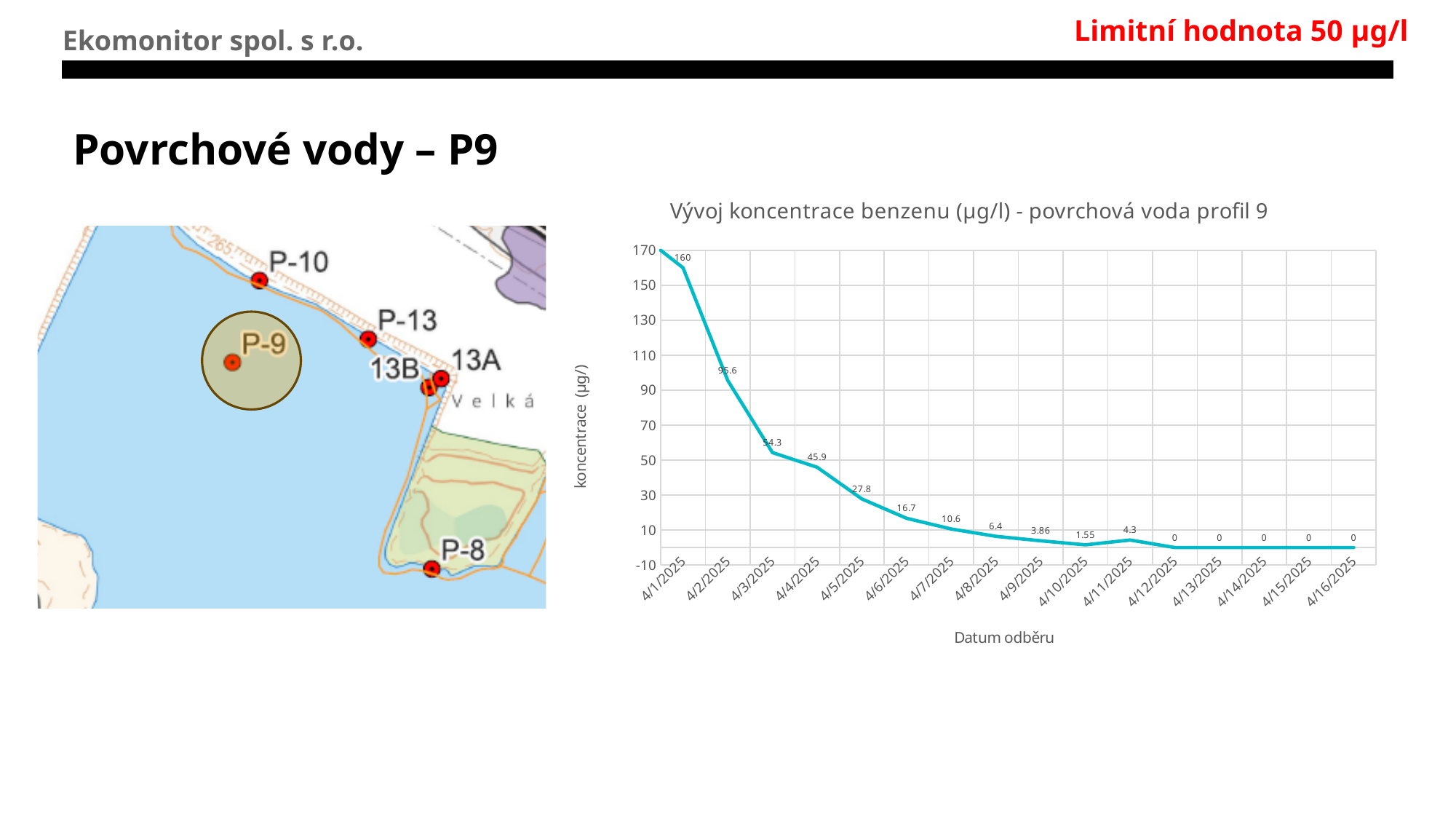
What type of chart is shown on the slide? line chart What is the title of the chart? Vývoj koncentrace benzenu (µg/l) - povrchová voda profil 9 On which date is the benzene concentration highest? 4/1/2025 Which is larger, the concentration on 4/10/2025 or on 4/11/2025? 4/11/2025 What is the difference between the concentrations on 4/1/2025 and 4/2/2025? 64.4 How many sampling dates are plotted on the x axis? 16 What is the benzene concentration on 4/1/2025? 160 Does the benzene concentration generally rise or fall from 4/1/2025 to 4/16/2025? fall What is the benzene concentration on 4/3/2025? 54.3 What is the benzene concentration on 4/11/2025? 4.3 What is the difference between the concentrations on 4/3/2025 and 4/4/2025? 8.4 What is the benzene concentration on 4/9/2025? 3.86